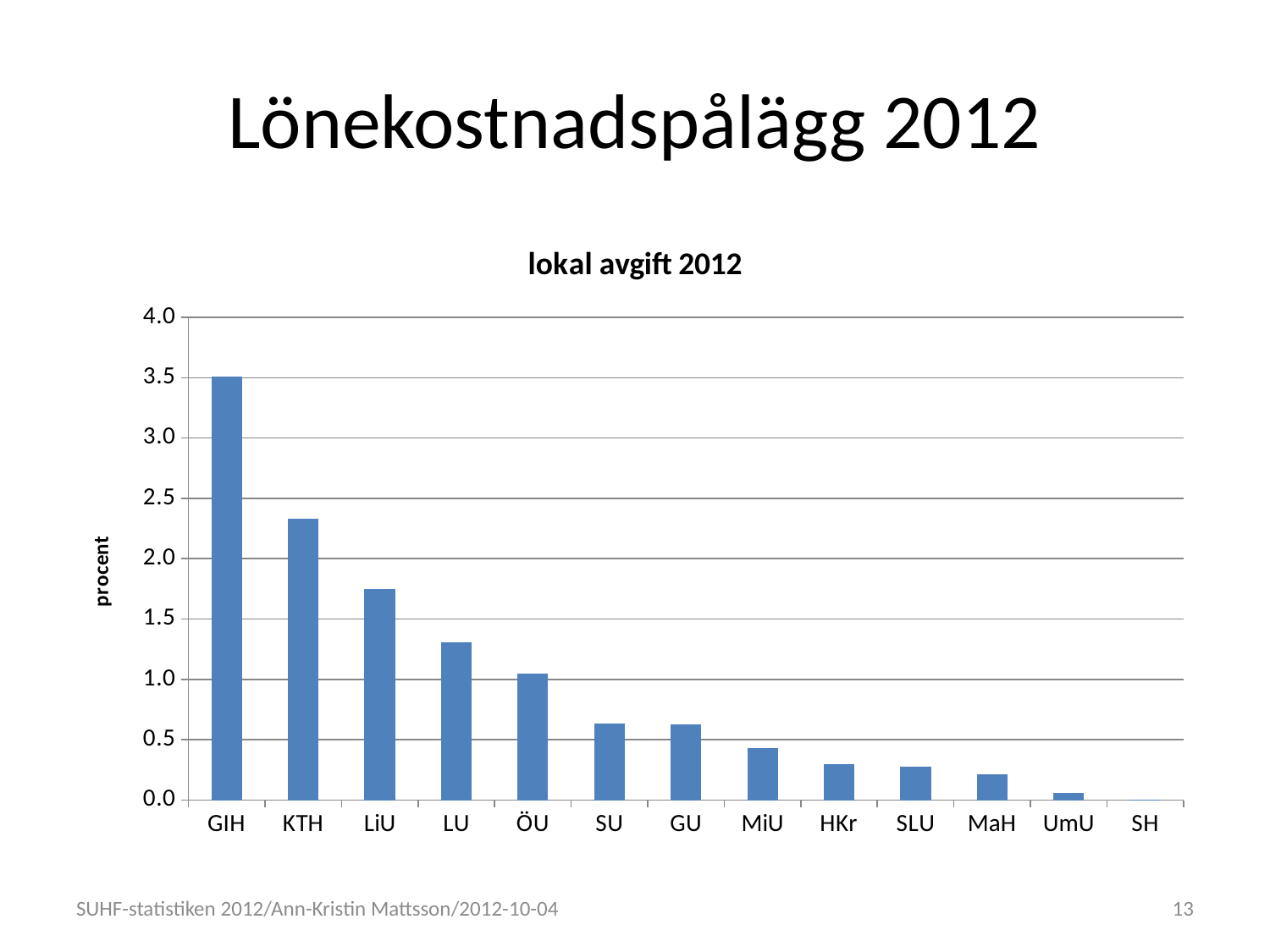
Is the value for MiU greater or less than 0.5? less Is the value for LiU greater or less than 2.0? less Is the value for KTH greater or less than 2.0? greater What is the title of the chart? lokal avgift 2012 What kind of chart is shown on the slide? bar chart Which institution has the lowest value in the chart? SH How many institutions are shown on the x axis of the chart? 13 Which institution has the highest value in the chart? GIH Which has the larger value, KTH or LiU? KTH What is the label on the vertical axis of the chart? procent Do the values rise or fall from left to right along the x axis? fall